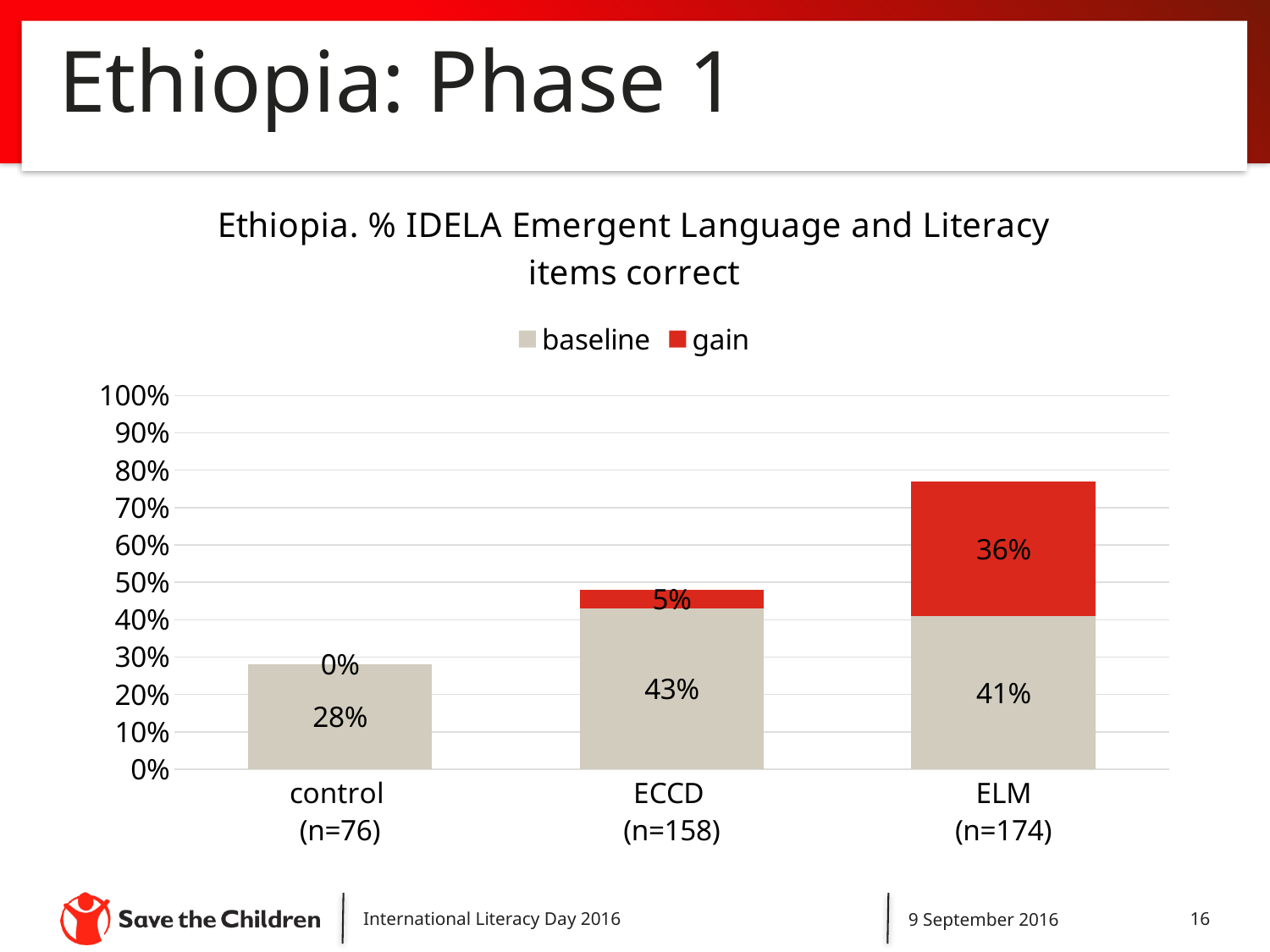
Which is larger, the baseline for ECCD or the baseline for ELM? ECCD How many series does the legend list? 2 What is the gain value for the ECCD group? 5% Which group has the highest gain? ELM (n=174) What is the difference between the gain for ELM and the gain for ECCD? 31% What is the gain value for the ELM group (n=174)? 36% What is the total height of the stacked bar for ELM (baseline plus gain)? 77% Which group has the lowest baseline value? control (n=76) What is the baseline value for the control group (n=76)? 28% What kind of chart is shown on the slide? Stacked bar chart What is the baseline value for the ECCD group (n=158)? 43% How many groups are shown on the x axis? 3